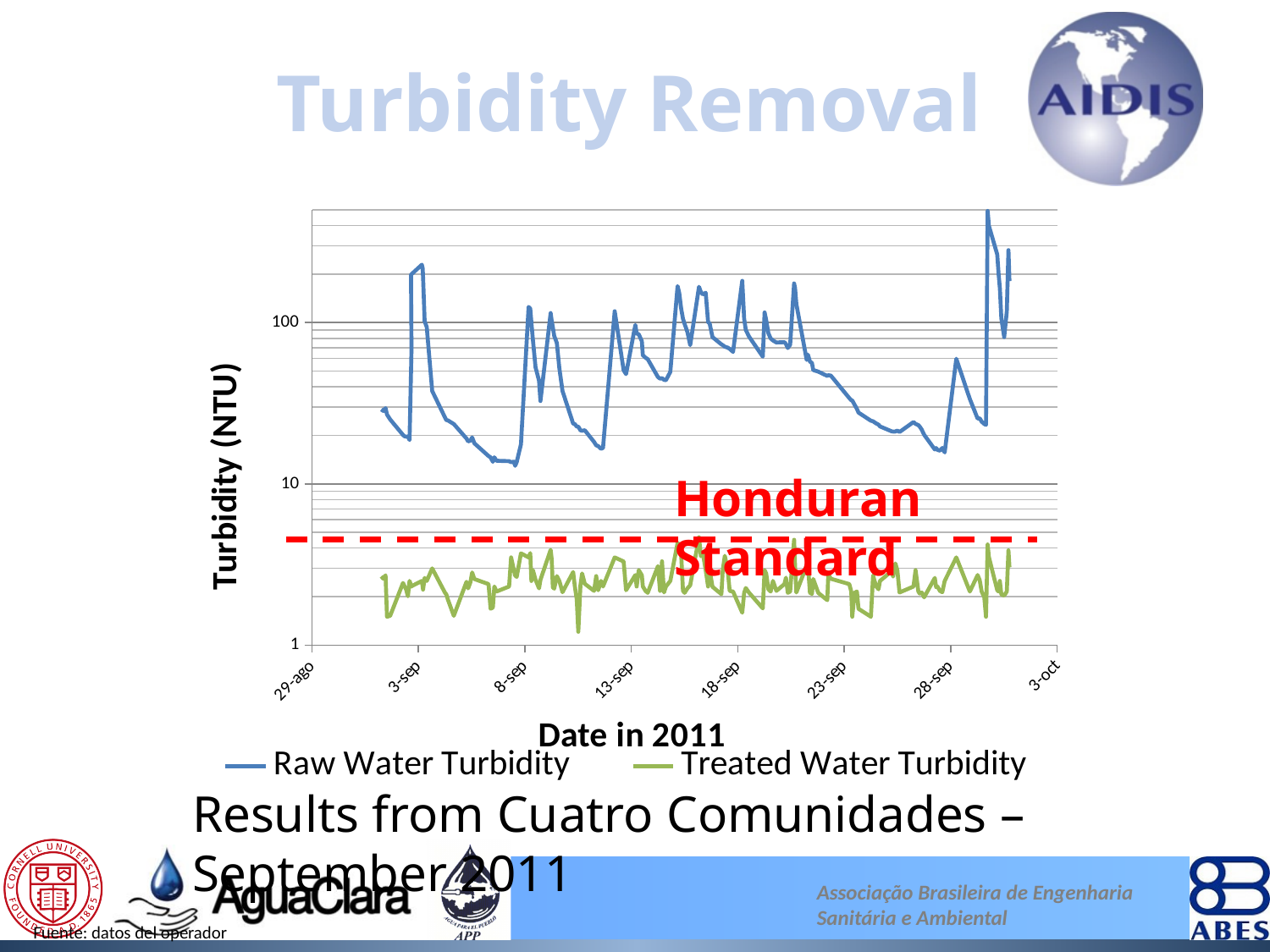
Is the value for Raw Water Turbidity on 18-sep greater or less than 10? greater Which series has the higher turbidity values throughout the period, Raw Water Turbidity or Treated Water Turbidity? Raw Water Turbidity Which series has the lowest turbidity values on the chart? Treated Water Turbidity What kind of chart is shown on the slide? line chart What does the red dashed horizontal line on the chart represent? Honduran Standard What are the two series named in the legend? Raw Water Turbidity and Treated Water Turbidity How many date labels are shown on the x axis? 8 How many series does the legend list? 2 Is the value for Treated Water Turbidity on 13-sep greater or less than 10? less Is the value for Treated Water Turbidity on 18-sep greater or less than 10? less Which series reaches the highest turbidity value on the chart? Raw Water Turbidity